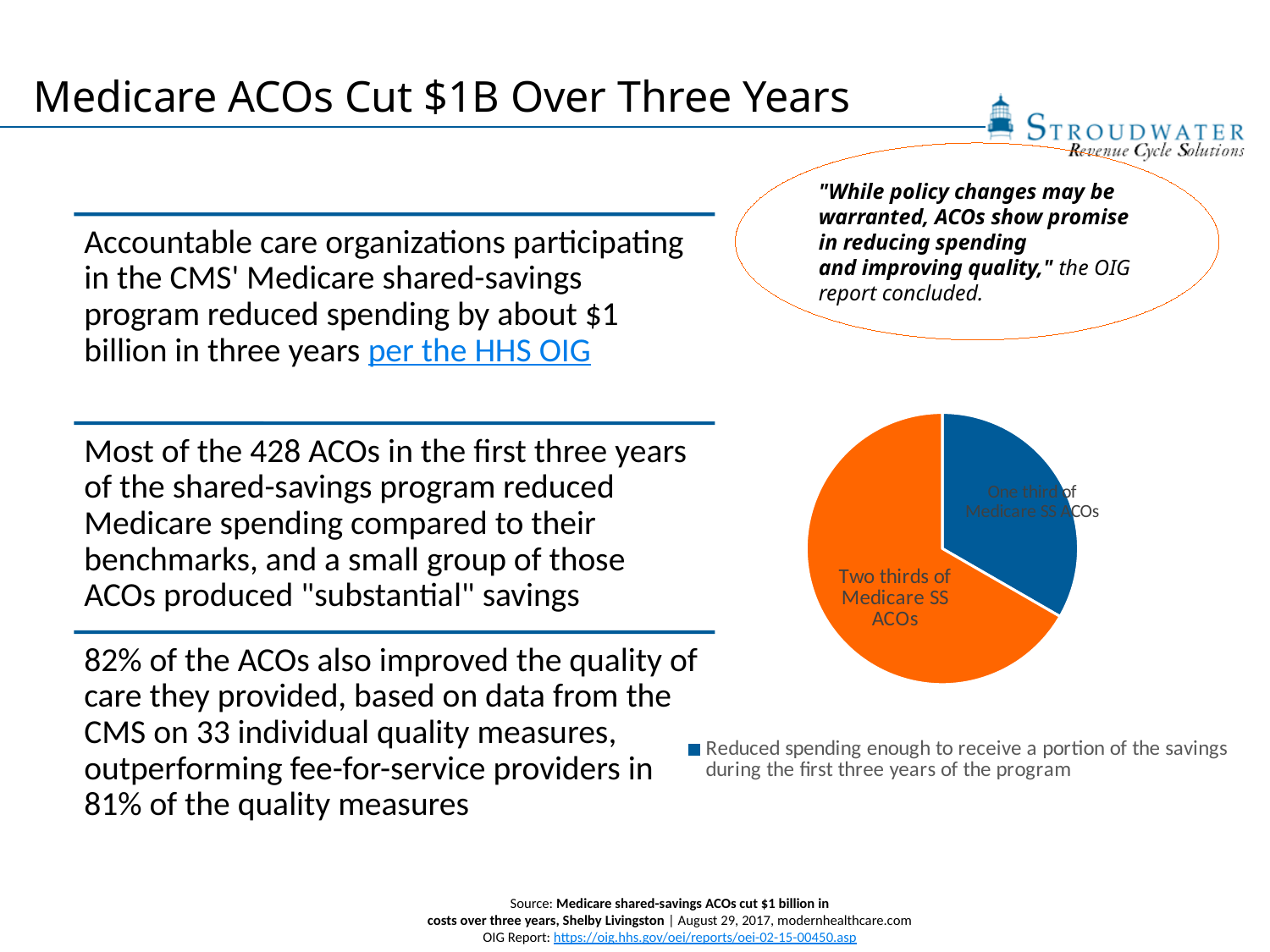
Which slice of the pie chart is larger, 'One third of Medicare SS ACOs' or 'Two thirds of Medicare SS ACOs'? Two thirds of Medicare SS ACOs What share of the pie does the blue slice represent, according to its label? One third Which slice of the pie chart is the smallest? One third of Medicare SS ACOs What share of the pie does the orange slice represent, according to its label? Two thirds What does the legend entry of the pie chart say? Reduced spending enough to receive a portion of the savings during the first three years of the program What colour is the slice labelled 'Two thirds of Medicare SS ACOs'? Orange Which slice of the pie chart is the largest? Two thirds of Medicare SS ACOs How many entries does the legend of the pie chart list? 1 What kind of chart is shown on the slide? Pie chart How many slices does the pie chart have? 2